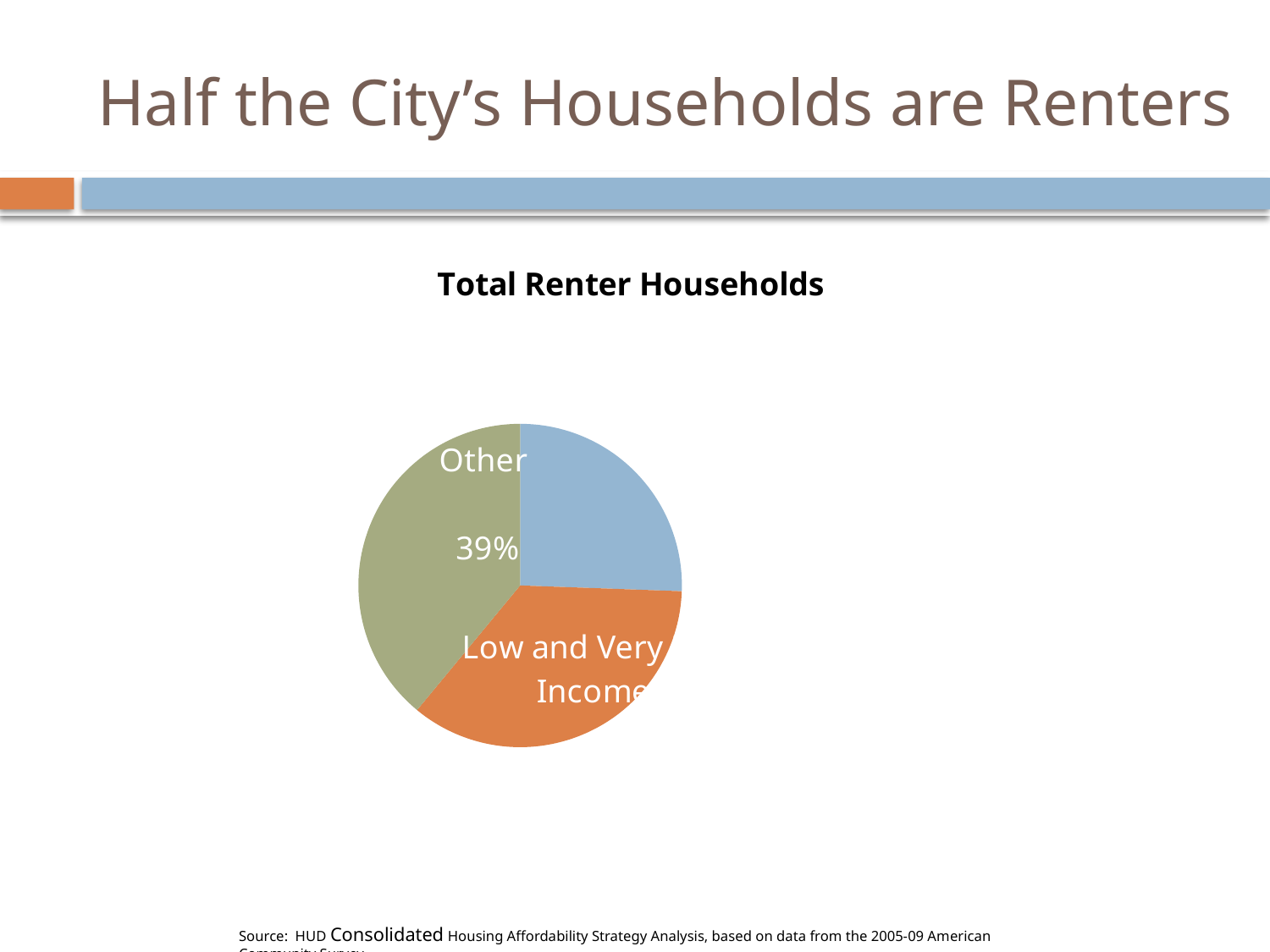
Is the share for "Other" greater or less than 50%? less How many slices does the pie chart have? 3 What colour is the "Other" slice of the pie chart? Green What kind of chart is shown on the slide? Pie chart Which is larger: the "Other" slice or the orange "Low and Very Low Income" slice? Other What is the title of the chart? Total Renter Households What share of total renter households is labelled "Other"? 39% Which slice of the pie chart is the largest? Other